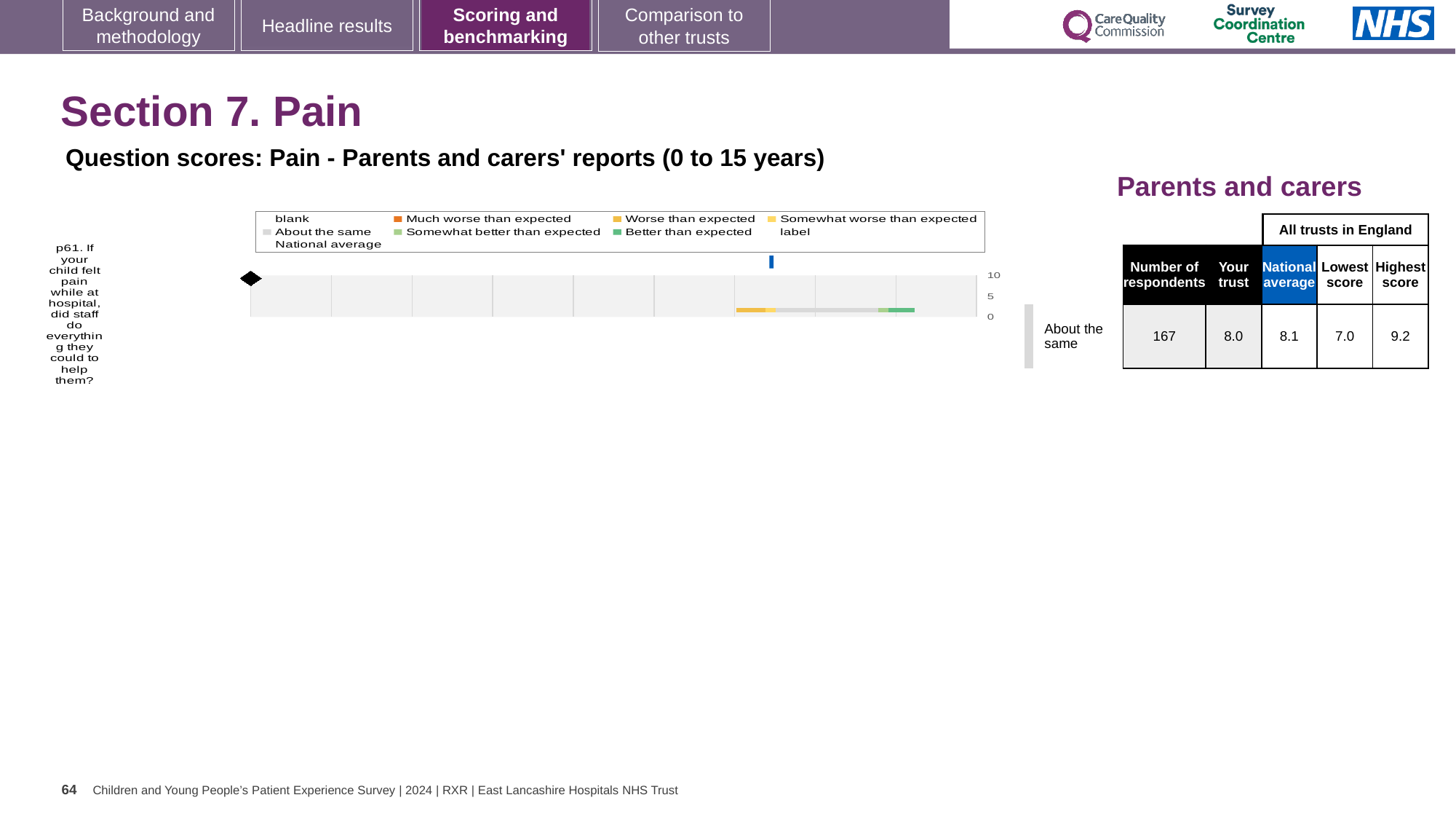
What kind of chart is shown on the slide? bar chart Which question number is plotted on the chart? p61 Which is larger for question p61, the trust's score or the national average? national average How many respondents answered question p61? 167 What is the 'Your trust' score for question p61? 8.0 What is the lowest score among all trusts in England for question p61? 7.0 What is the difference between the national average and the trust's score for question p61? 0.1 How many survey questions are plotted on the chart? 1 What is the highest score among all trusts in England for question p61? 9.2 What is the difference between the highest and lowest scores for question p61? 2.2 What benchmark category is the trust's result for question p61 labelled as? About the same What is the national average score for question p61? 8.1